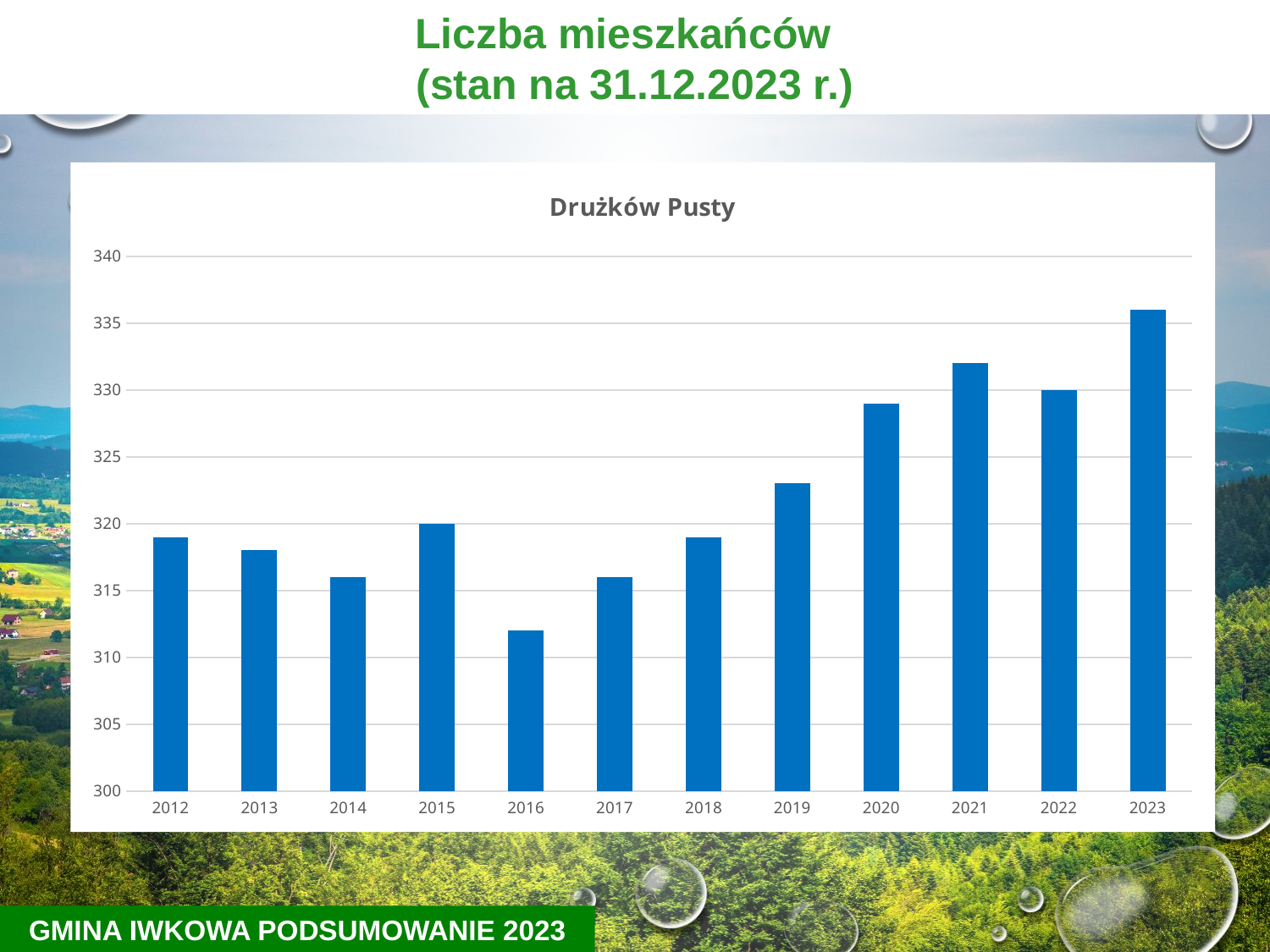
Which year has the lowest value in the chart? 2016 What is the value for 2022? 330 Is the value for 2023 greater or less than 335? greater How many years are shown on the x axis of the chart? 12 Which year has the highest value in the chart? 2023 What is the value for 2015? 320 Which is larger, the value for 2019 or the value for 2020? 2020 What is the difference between the values for 2022 and 2015? 10 What is the title of the chart? Drużków Pusty What kind of chart is shown on the slide? bar chart Is the value for 2016 greater or less than 315? less Do the values generally rise or fall from 2016 to 2023? rise